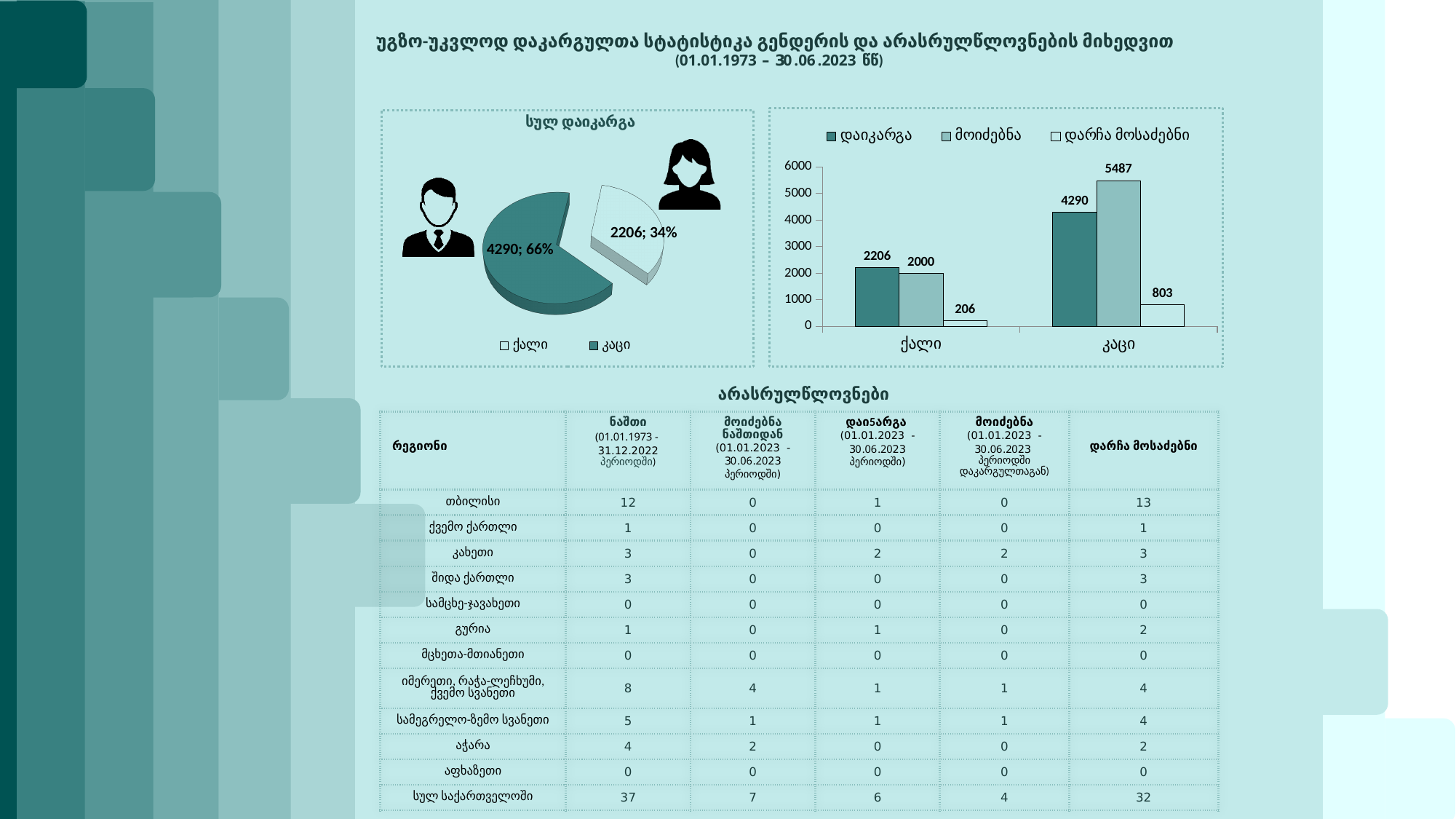
In the bar chart on the right, what is the difference between დაიკარგა and მოიძებნა for ქალი? 206 What kind of chart is the chart on the left titled "სულ დაიკარგა"? pie chart In the bar chart on the right, which is larger for კაცი: დაიკარგა or მოიძებნა? მოიძებნა What kind of chart is the chart on the right of the slide? bar chart In the bar chart on the right, what is the difference between the დარჩა მოსაძებნი values for კაცი and ქალი? 597 In the bar chart on the right, what is the value of მოიძებნა for კაცი? 5487 In the bar chart on the right, what is the value of დარჩა მოსაძებნი for ქალი? 206 In the pie chart titled "სულ დაიკარგა", what share of the pie does the ქალი slice represent? 34% In the bar chart on the right, how many series does the legend list? 3 In the bar chart on the right, which category has the highest დაიკარგა value? კაცი How many slices does the pie chart titled "სულ დაიკარგა" have? 2 In the pie chart titled "სულ დაიკარგა", what value and share are shown for the კაცი slice? 4290; 66%